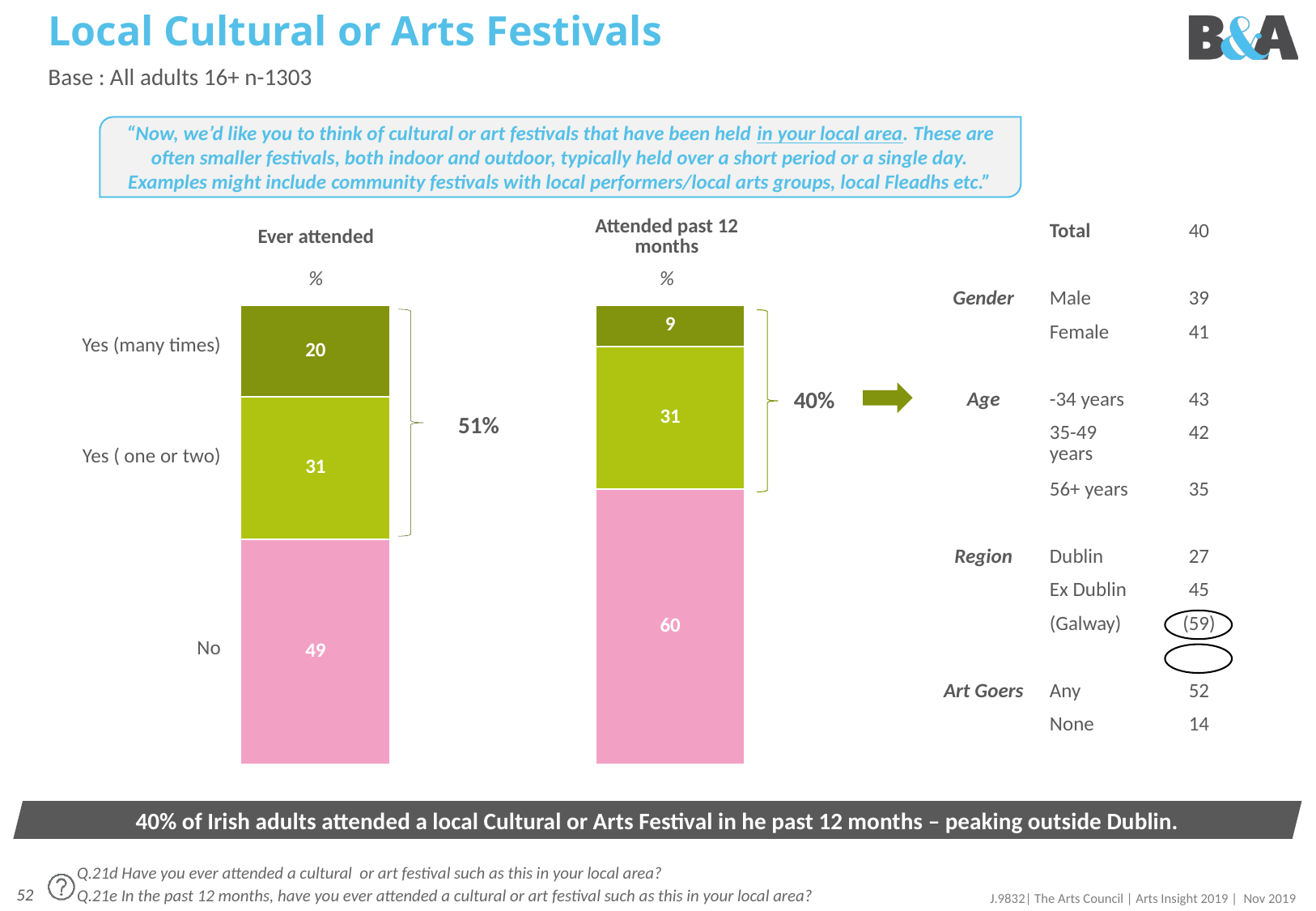
In the 'Ever attended' chart, what percentage answered 'Yes (many times)'? 20 Which is larger: the 'Yes (many times)' value in the 'Ever attended' chart or the 'Yes (many times)' value in the 'Attended past 12 months' chart? Ever attended In the 'Ever attended' chart, which response category has the largest value? No How many segments make up the 'Attended past 12 months' stacked bar? 3 In the 'Attended past 12 months' chart, which response category has the smallest value? Yes (many times) What combined percentage is shown by the bracket for the two 'Yes' segments in the 'Attended past 12 months' chart? 40% In the 'Ever attended' chart, what is the difference between the 'No' value and the 'Yes (one or two)' value? 18 What type of chart is used to show the 'Ever attended' results? Stacked bar chart In the 'Attended past 12 months' chart, what percentage answered 'Yes (many times)'? 9 In the 'Attended past 12 months' chart, what percentage answered 'No'? 60 In the 'Ever attended' chart, what percentage answered 'No'? 49 What combined percentage is shown by the bracket for the two 'Yes' segments in the 'Ever attended' chart? 51%